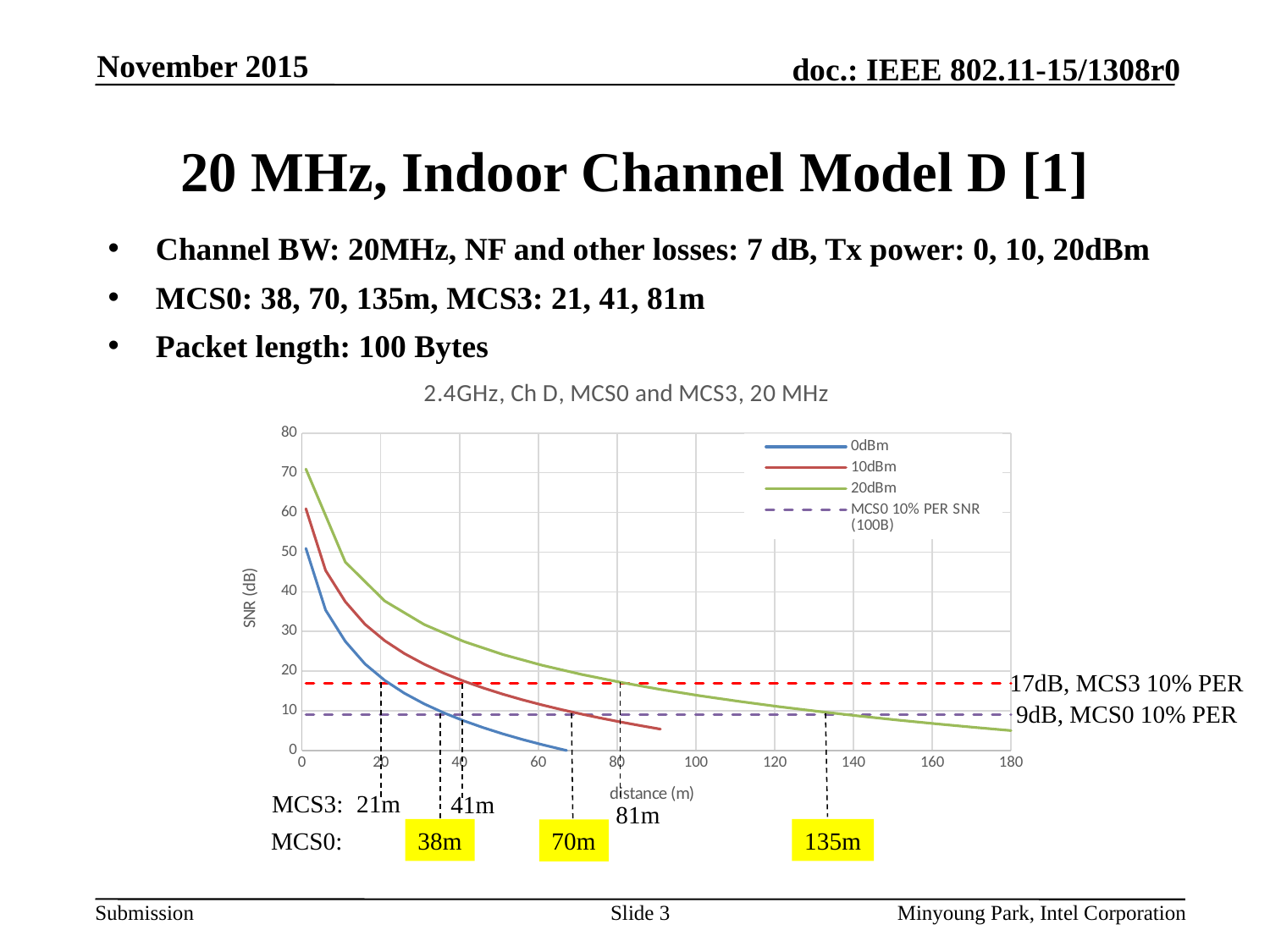
What is the title of the chart? 2.4GHz, Ch D, MCS0 and MCS3, 20 MHz What SNR value is marked as the MCS3 10% PER threshold? 17dB Which series has the highest SNR at any given distance? 20dBm At what distance does the 20dBm curve reach the MCS0 10% PER threshold? 135m How many series does the chart legend list? 4 What is the difference between the MCS3 and MCS0 10% PER SNR thresholds marked on the chart? 8dB What kind of chart is shown on the slide? line chart What is the label of the y axis of the chart? SNR (dB) What SNR value is marked as the MCS0 10% PER threshold? 9dB Is the SNR of the 0dBm series at a distance of 40 m greater or less than 20? less Do the SNR curves rise or fall as distance increases along the x axis? fall Which series has the lowest SNR at any given distance? 0dBm